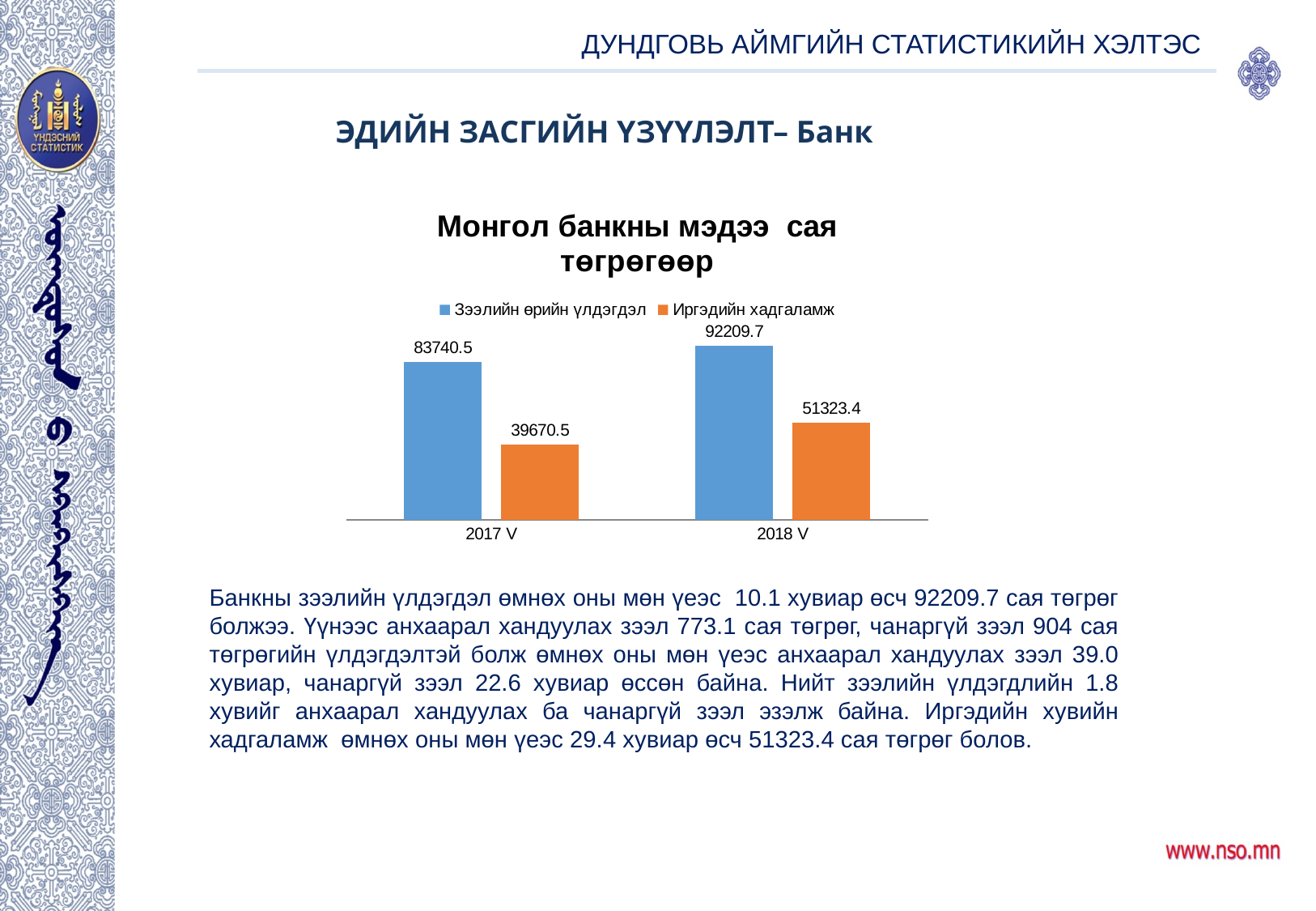
How many series does the legend list? 2 What is the value of Зээлийн өрийн үлдэгдэл for 2017 V? 83740.5 Does Иргэдийн хадгаламж rise or fall from 2017 V to 2018 V? Rise What is the value of Иргэдийн хадгаламж for 2017 V? 39670.5 Which period has the lower value for Иргэдийн хадгаламж? 2017 V By how much did Зээлийн өрийн үлдэгдэл increase from 2017 V to 2018 V? 8469.2 What is the value of Иргэдийн хадгаламж for 2018 V? 51323.4 Which period has the higher value for Зээлийн өрийн үлдэгдэл? 2018 V What kind of chart is shown on the slide? Bar chart Which is larger in 2017 V: Зээлийн өрийн үлдэгдэл or Иргэдийн хадгаламж? Зээлийн өрийн үлдэгдэл What is the difference between Зээлийн өрийн үлдэгдэл and Иргэдийн хадгаламж in 2018 V? 40886.3 What is the value of Зээлийн өрийн үлдэгдэл for 2018 V? 92209.7